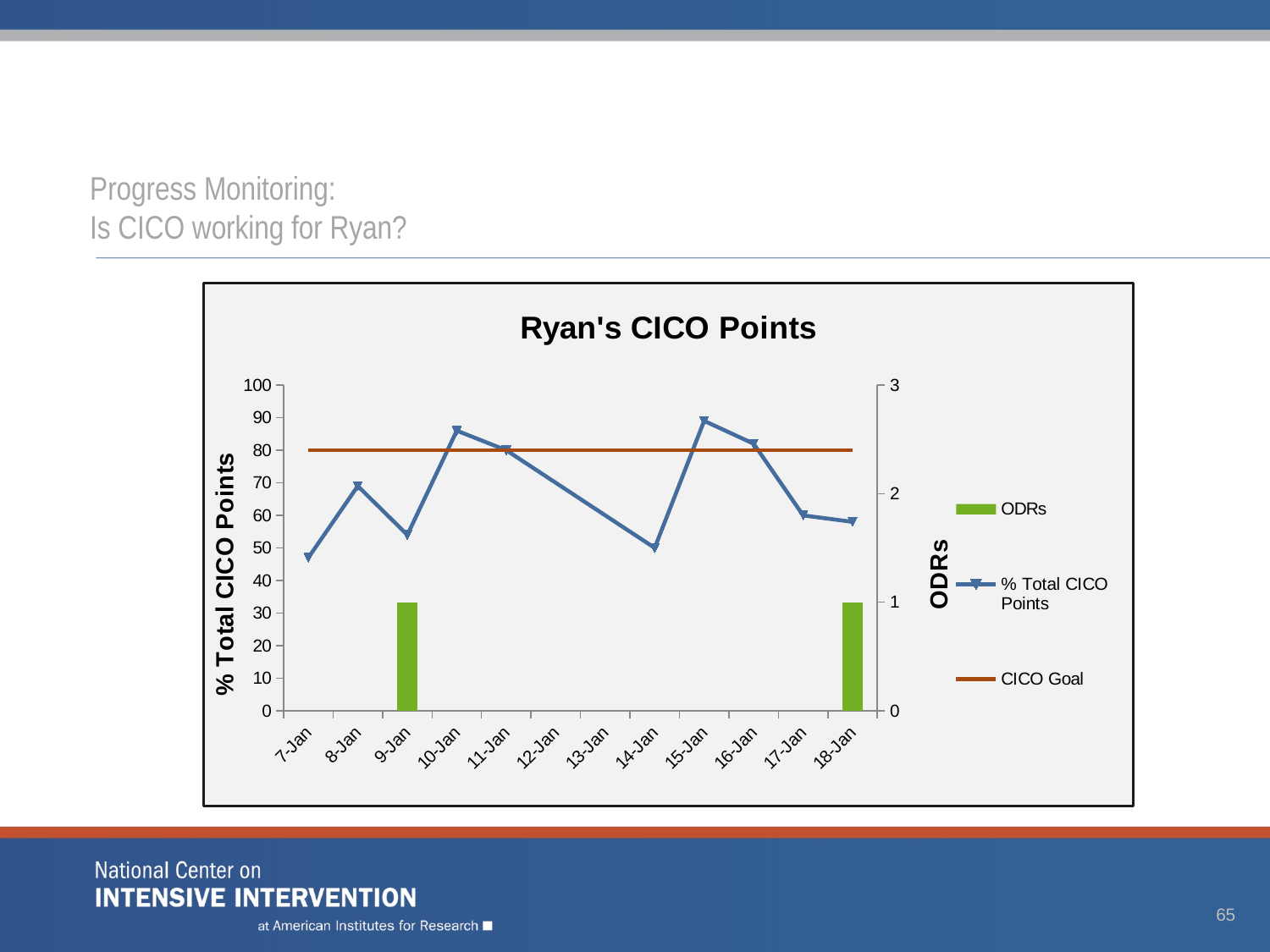
Which date has the higher % Total CICO Points, 9-Jan or 10-Jan? 10-Jan Is the % Total CICO Points value for 15-Jan greater or less than 80? greater On how many dates does an ODRs bar appear? 2 What is the label on the right-hand vertical axis? ODRs How many series does the legend list? 3 How many ODRs are shown for 9-Jan on the right axis? 1 What value does the CICO Goal line sit at on the left axis? 80 What is the title of the chart? Ryan's CICO Points Is the % Total CICO Points value for 10-Jan greater or less than 80? greater How many ODRs are shown for 18-Jan on the right axis? 1 Do the % Total CICO Points rise or fall from 15-Jan to 18-Jan? fall How many dates are shown on the x axis? 12